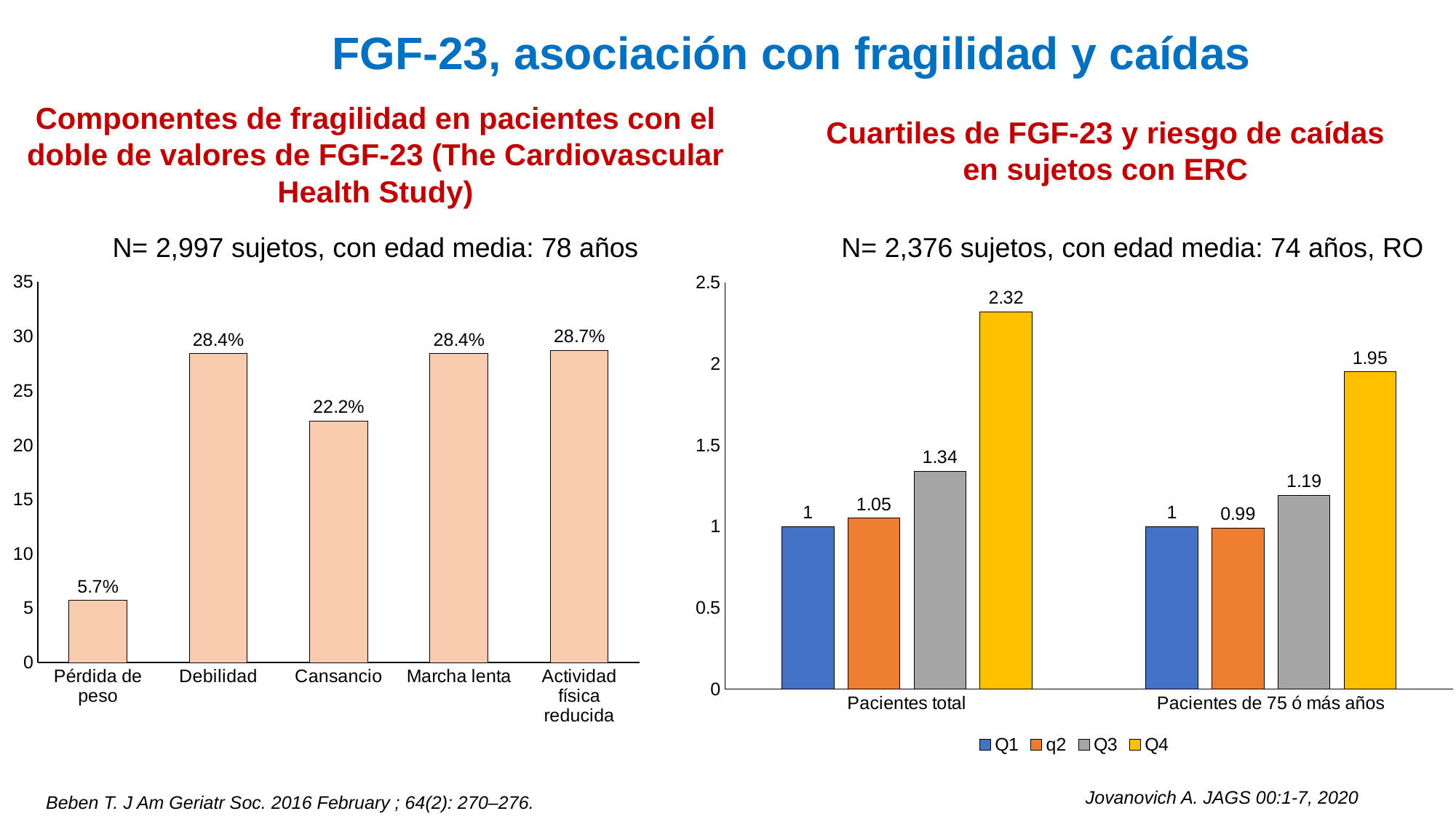
In the right chart (Cuartiles de FGF-23), what is the value for Q3 in Pacientes de 75 ó más años? 1.19 In the left chart (Componentes de fragilidad), which category has the lowest value? Pérdida de peso In the left chart (Componentes de fragilidad), is the value for Cansancio greater or less than 20? greater In the left chart (Componentes de fragilidad), what kind of chart is it? Bar chart In the right chart (Cuartiles de FGF-23), how many series does the legend list? 4 In the right chart (Cuartiles de FGF-23), what colour are the Q4 bars? Yellow In the left chart (Componentes de fragilidad), how many categories are shown on the x axis? 5 In the left chart (Componentes de fragilidad), what is the value for Cansancio? 22.2% In the right chart (Cuartiles de FGF-23), what is the difference between Q4 and Q1 in Pacientes total? 1.32 In the right chart (Cuartiles de FGF-23), what is the value for Q4 in Pacientes total? 2.32 In the left chart (Componentes de fragilidad), what is the difference between Debilidad and Pérdida de peso? 22.7% In the right chart (Cuartiles de FGF-23), which is larger for Q4: Pacientes total or Pacientes de 75 ó más años? Pacientes total